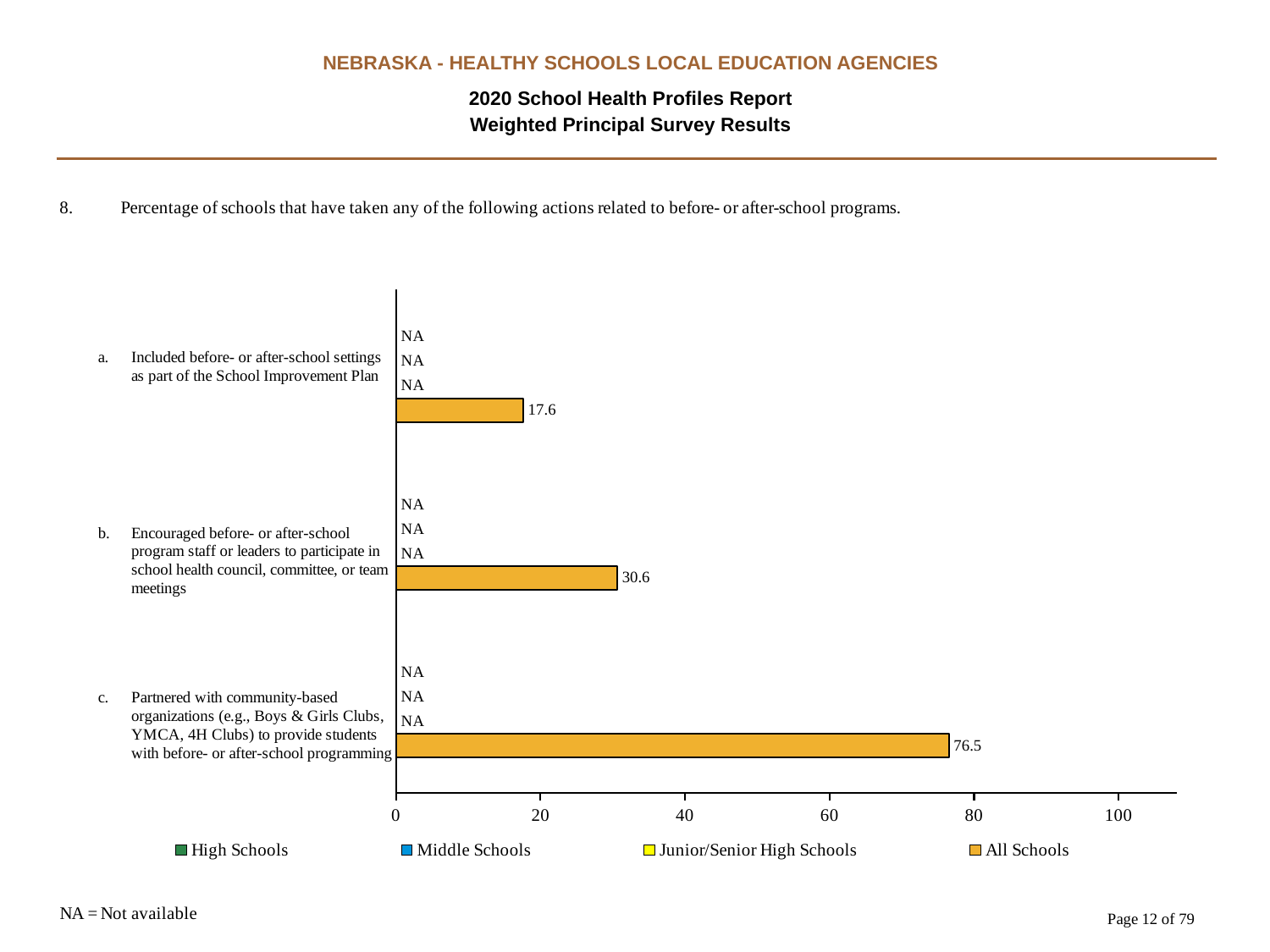
What is the difference between the All Schools values for item b and item a? 13 What is the difference between the All Schools values for item c and item a? 58.9 What is the All Schools value for item b, encouraged before- or after-school program staff or leaders to participate in school health council, committee, or team meetings? 30.6 Which item has the lowest All Schools value? a. Included before- or after-school settings as part of the School Improvement Plan Which item has the highest All Schools value? c. Partnered with community-based organizations to provide before- or after-school programming What is the All Schools value for item c, partnered with community-based organizations to provide before- or after-school programming? 76.5 Is the All Schools value for item b larger or smaller than the All Schools value for item c? smaller What kind of chart is shown on the slide? bar chart How many items (categories) are shown on the chart? 3 What is the All Schools value for item a, included before- or after-school settings as part of the School Improvement Plan? 17.6 How many series does the legend list? 4 What value is shown for High Schools for item a? NA